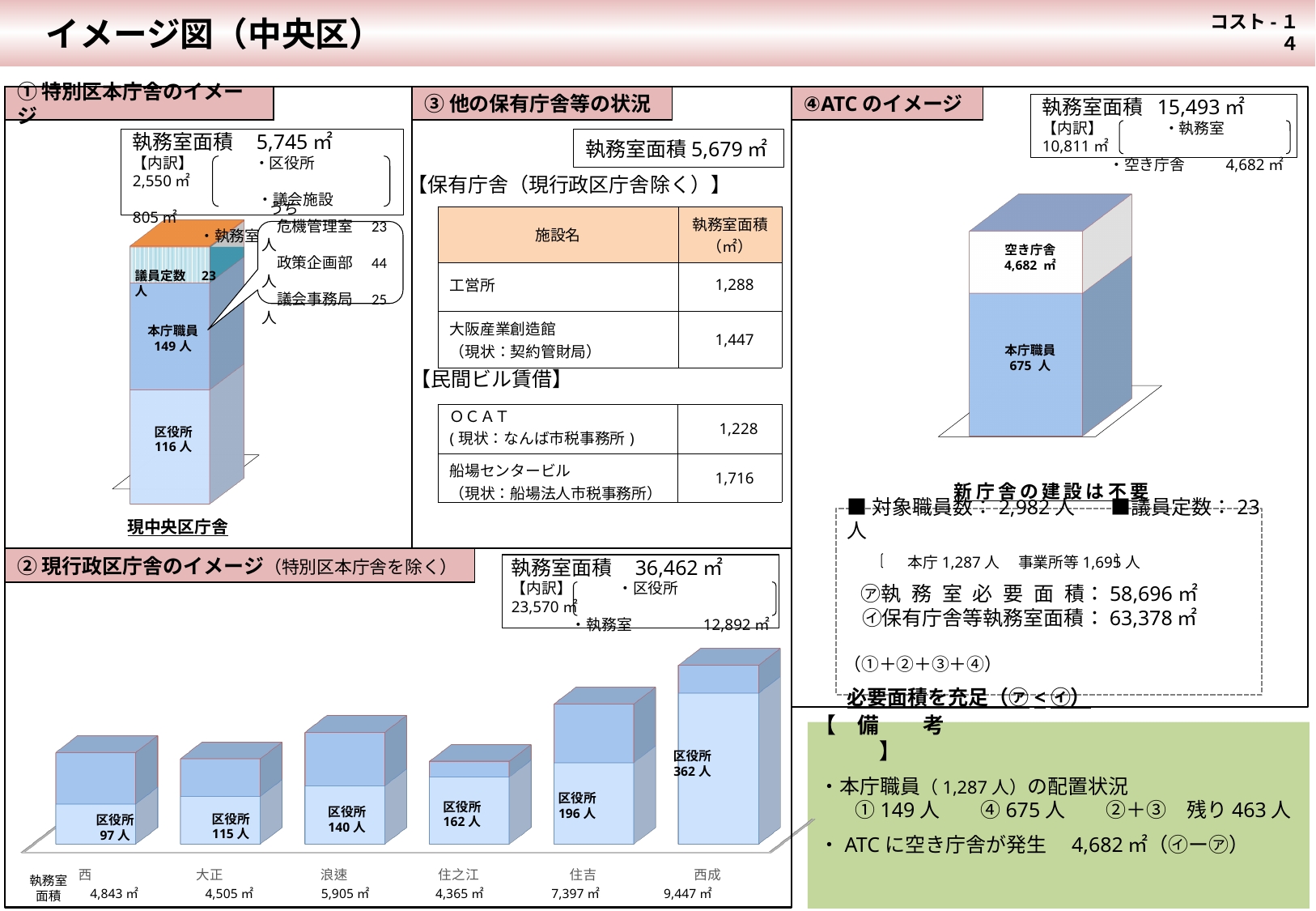
In the chart ② 現行政区庁舎のイメージ, how many wards are shown? 6 In the chart ④ ATC のイメージ, what is the 空き庁舎 area shown in the building? 4,682 ㎡ In the chart ① 特別区本庁舎のイメージ, how many 本庁職員 are shown in the 現中央区庁舎 building? 149 人 In the chart ② 現行政区庁舎のイメージ, which ward has the smallest 執務室面積? 住之江 In the chart ② 現行政区庁舎のイメージ, do the 区役所 staff counts rise or fall from 住之江 to 西成? rise In the chart ② 現行政区庁舎のイメージ, which ward has the highest 区役所 staff count? 西成 In the chart ② 現行政区庁舎のイメージ, what is the difference in 区役所 staff between 西成 and 住吉? 166 人 In the chart ② 現行政区庁舎のイメージ, which has more 区役所 staff, 浪速 or 住之江? 住之江 In the chart ① 特別区本庁舎のイメージ, what is the total of 区役所, 本庁職員 and 議員定数 shown in the stacked building? 288 人 In the chart ② 現行政区庁舎のイメージ, which ward has the lowest 区役所 staff count? 西 In the chart ② 現行政区庁舎のイメージ, what is the 執務室面積 shown for 住吉? 7,397 ㎡ In the chart ② 現行政区庁舎のイメージ, how many 区役所 staff are shown for 西成? 362 人